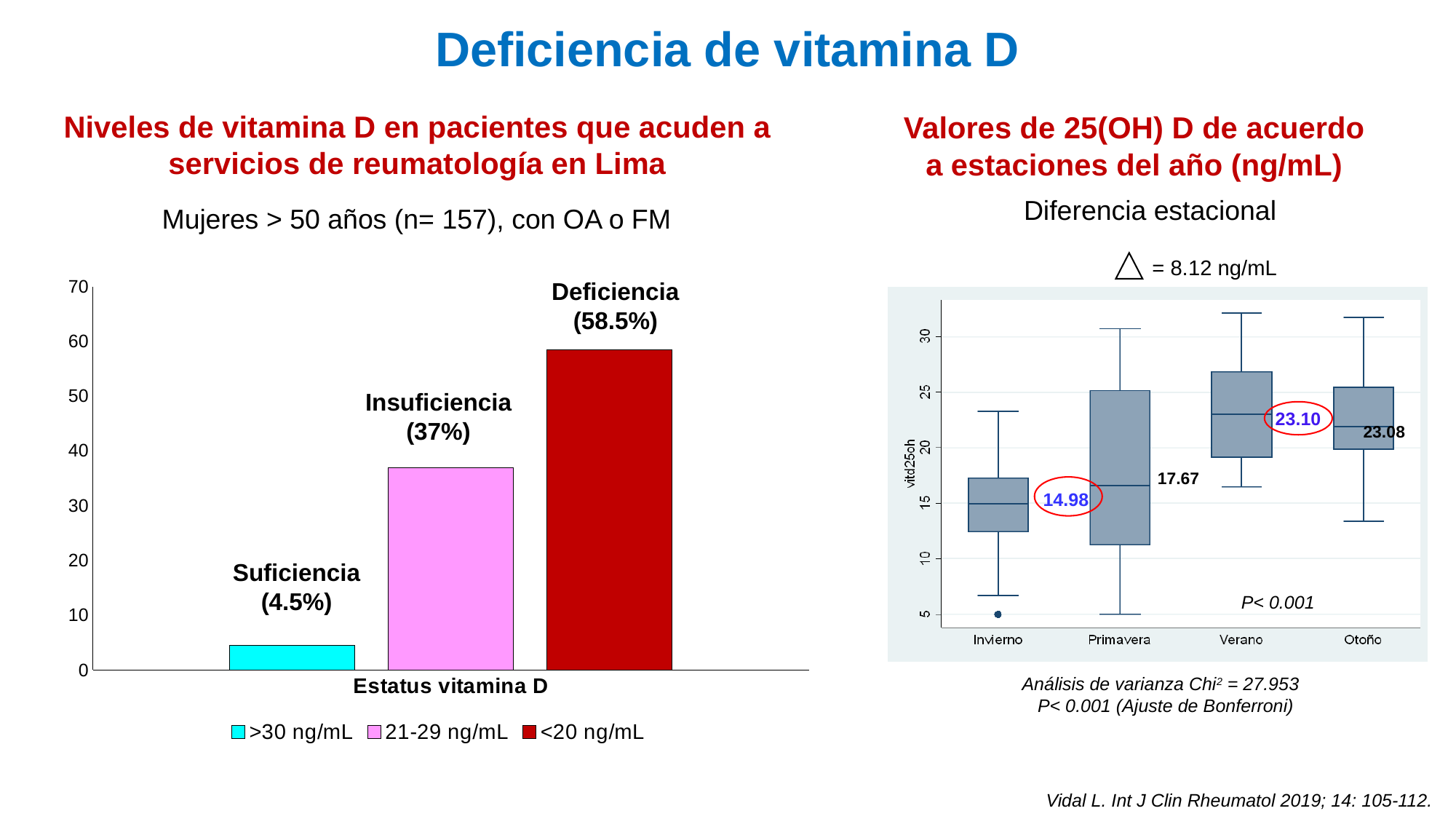
In the left bar chart, which category has the highest bar? Deficiencia In the left bar chart, is the value for Deficiencia greater or less than 50? greater What kind of chart is the left chart on the slide? bar chart In the right box plot, what median value is labelled for Primavera? 17.67 How many seasons are shown on the x axis of the right box plot? 4 In the left bar chart, which category has the lowest bar? Suficiencia In the right box plot, what median value is labelled for Invierno? 14.98 How many legend entries does the left bar chart have? 3 In the left bar chart, which is larger, Insuficiencia or Suficiencia? Insuficiencia In the left bar chart, what is the difference between the Deficiencia and Insuficiencia percentages? 21.5% In the left bar chart, what percentage is shown for Suficiencia? 4.5% In the left bar chart, what percentage is shown for Deficiencia? 58.5%